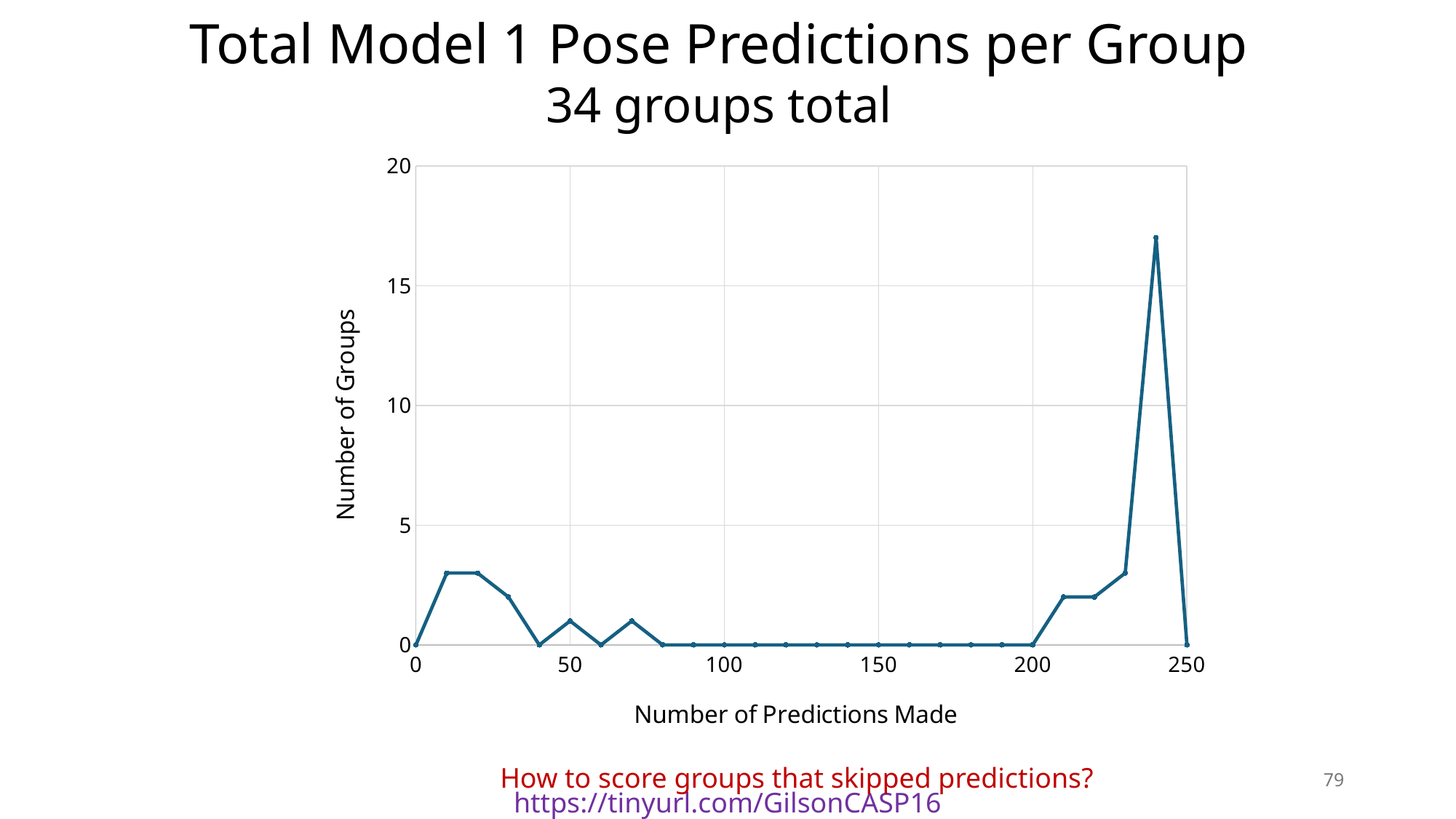
Is the number of groups at 230 predictions made greater or less than 5? less What is the title of the chart? Total Model 1 Pose Predictions per Group Is the number of groups at 240 predictions made greater or less than 15? greater Which has more groups: 230 predictions made or 50 predictions made? 230 What is the label of the x axis? Number of Predictions Made Which has more groups: 240 predictions made or 10 predictions made? 240 Does the number of groups rise or fall between 200 and 240 predictions made? rise What kind of chart is shown on the slide? line chart Is the number of groups at 10 predictions made greater or less than 5? less At which number of predictions made is the number of groups highest? 240 What is the number of groups at 250 predictions made? 0 What is the number of groups at 100 predictions made? 0